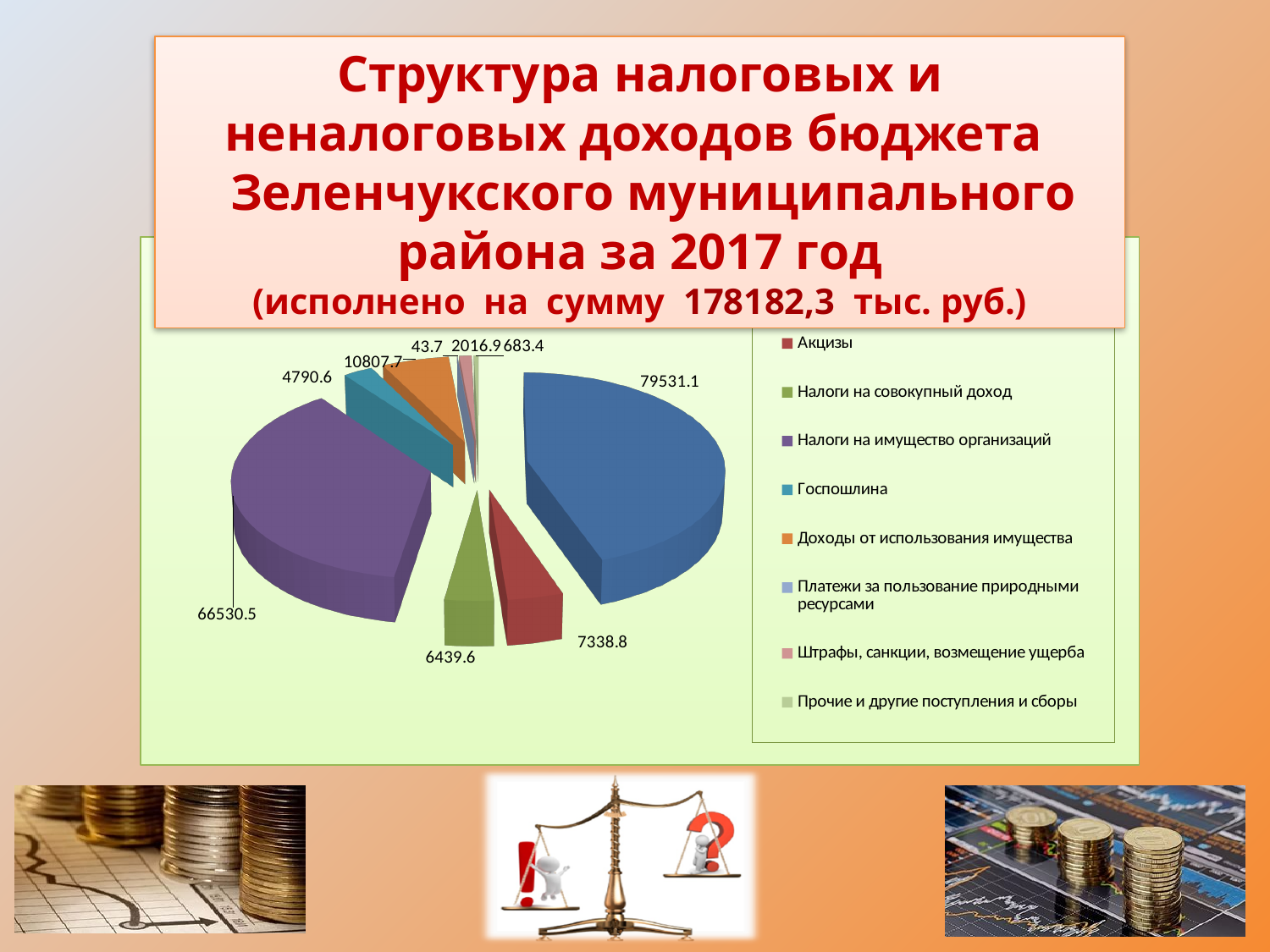
According to the slide title, what total sum was executed in 2017? 178182,3 тыс. руб. What is the difference between Доходы от использования имущества and Госпошлина? 6017.1 How many slices does the pie chart have? 9 What is the value shown for Акцизы on the pie chart? 7338.8 Which is larger: Акцизы or Налоги на совокупный доход? Акцизы What is the value shown for Штрафы, санкции, возмещение ущерба? 2016.9 What is the value shown for Госпошлина? 4790.6 Which category has the smallest slice in the pie chart? Платежи за пользование природными ресурсами What is the value of the largest slice in the pie chart? 79531.1 What is the value shown for Налоги на имущество организаций? 66530.5 What is the value shown for Доходы от использования имущества? 10807.7 What type of chart is shown on the slide? Pie chart